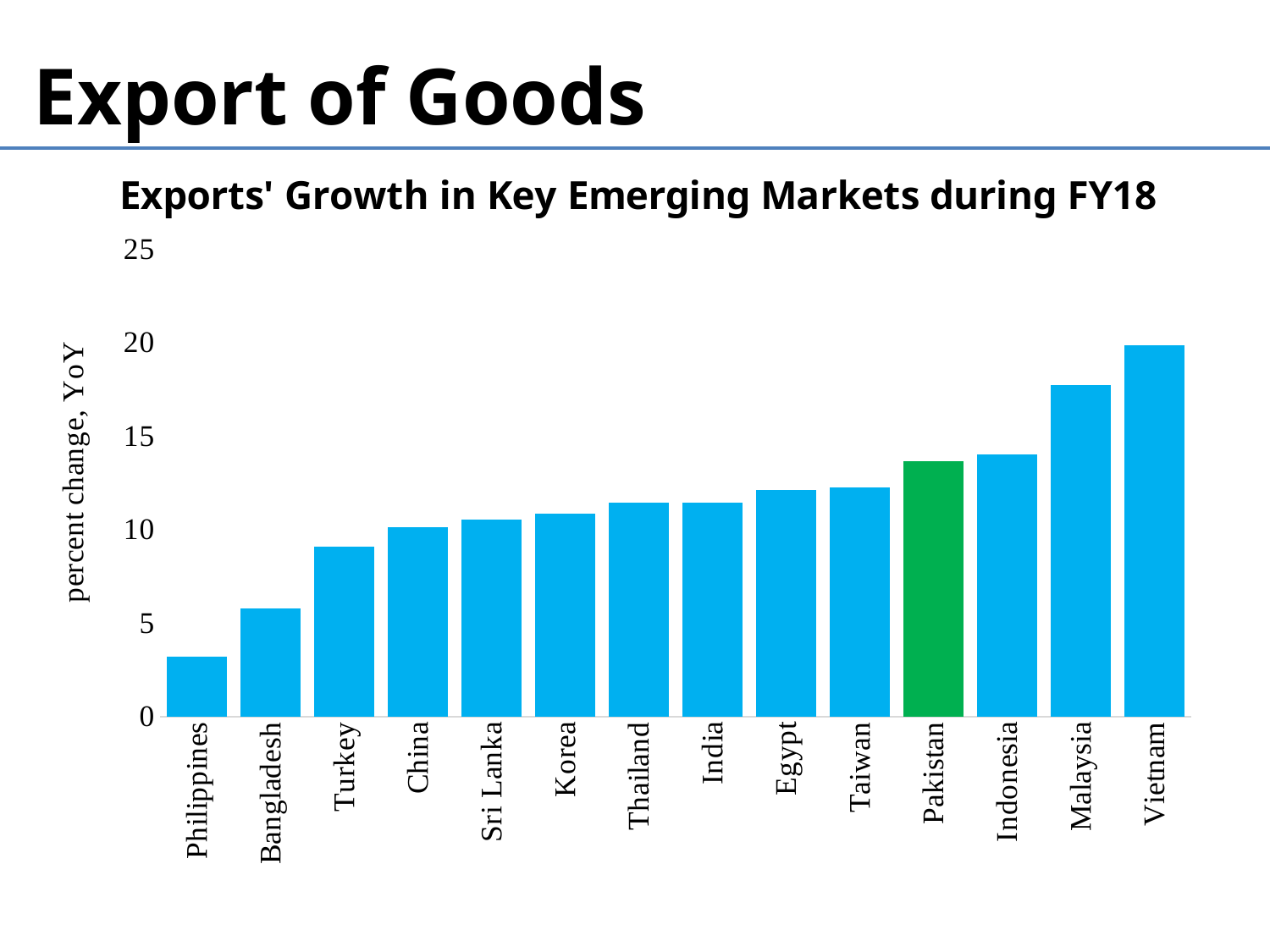
How many countries are shown in the chart? 14 Which country has the highest export growth in the chart? Vietnam Is the value for Bangladesh greater or less than 5? greater What kind of chart is shown on the slide? bar chart Do the values rise or fall moving from left to right along the x axis? rise Which country has the lowest export growth in the chart? Philippines Is the value for Pakistan greater or less than 15? less Is the value for Malaysia greater or less than 15? greater Which country's bar is highlighted in green? Pakistan Which has the larger export growth, Malaysia or Pakistan? Malaysia